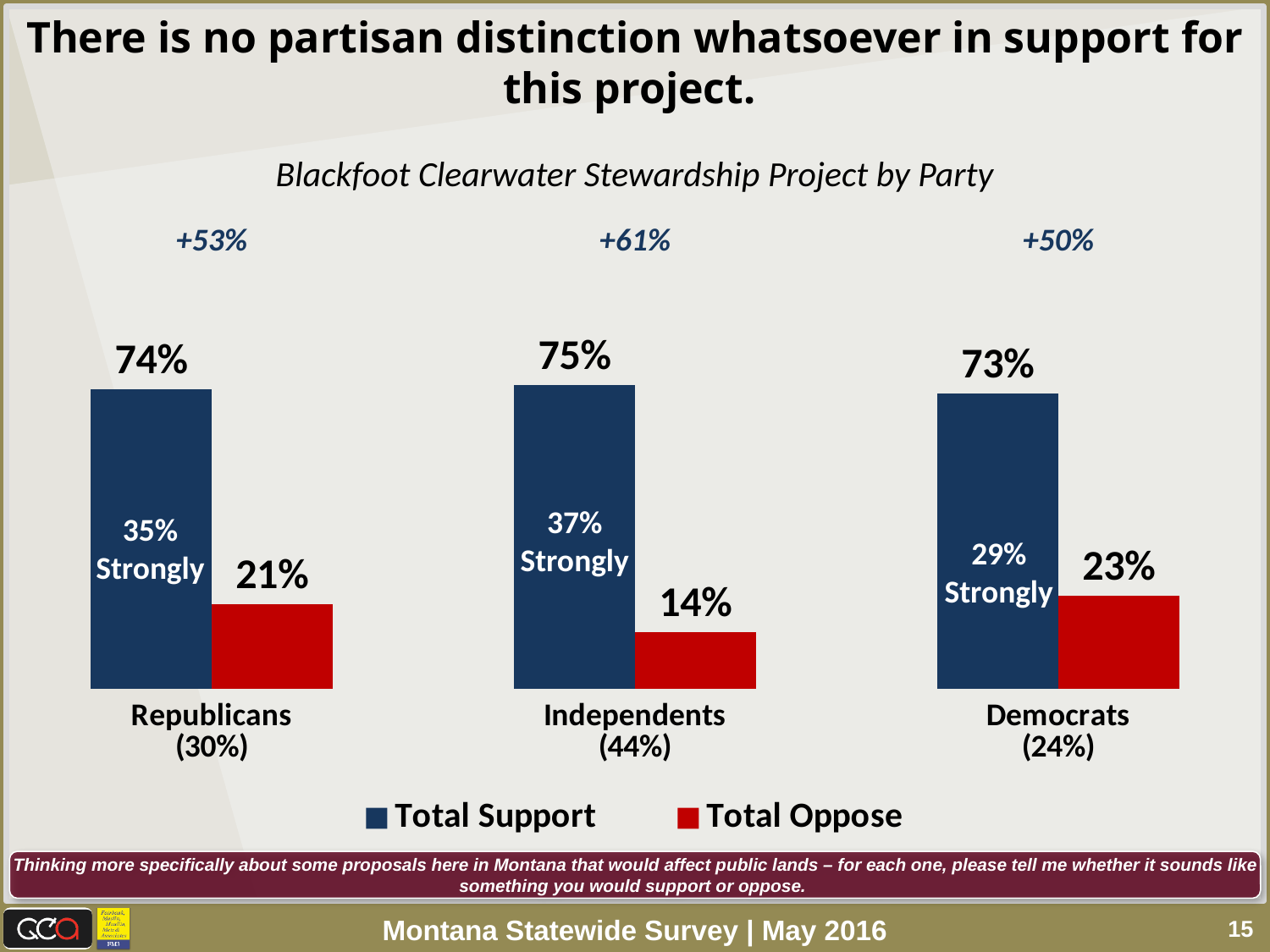
What kind of chart is shown on the slide? Bar chart Which party group has the highest Total Support? Independents What is the difference between Total Support and Total Oppose for Republicans? 53% Which is larger for Democrats: Total Support or Total Oppose? Total Support What is the Total Support value for Independents? 75% What percentage of Independents strongly support the project? 37% What is the Total Oppose value for Democrats? 23% Which party group has the lowest Total Oppose? Independents How many series does the legend list? 2 What is the Total Oppose value for Republicans? 21% How many party groups are shown on the x axis? 3 What is the title of the chart? Blackfoot Clearwater Stewardship Project by Party